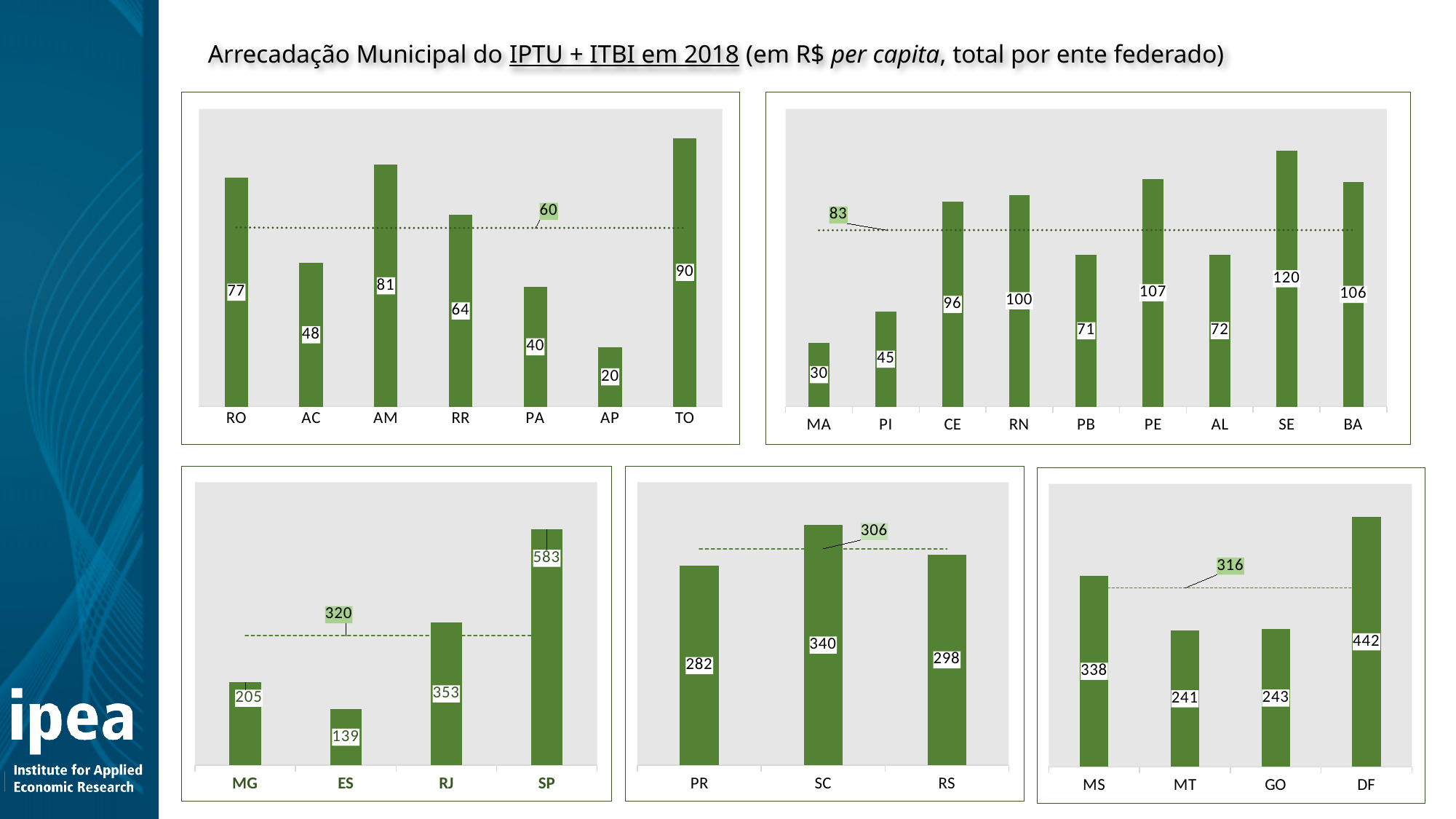
In the bottom-left chart (MG, ES, RJ, SP), what is the value for ES? 139 In the top-left chart (RO to TO), what is the value for AM? 81 In the bottom-middle chart (PR, SC, RS), which is larger, PR or RS? RS In the bottom-right chart (MS, MT, GO, DF), what is the value for DF? 442 In the top-left chart (RO to TO), what is the difference between TO and PA? 50 In the top-right chart (MA to BA), how many states are shown? 9 In the top-right chart (MA to BA), what is the value for PE? 107 In the top-right chart (MA to BA), which state has the highest value? SE What kind of chart is used on this slide? Bar chart In the bottom-left chart (MG, ES, RJ, SP), what is the difference between SP and RJ? 230 In the top-left chart (RO to TO), which state has the lowest value? AP In the bottom-right chart (MS, MT, GO, DF), what value is marked by the dashed reference line? 316